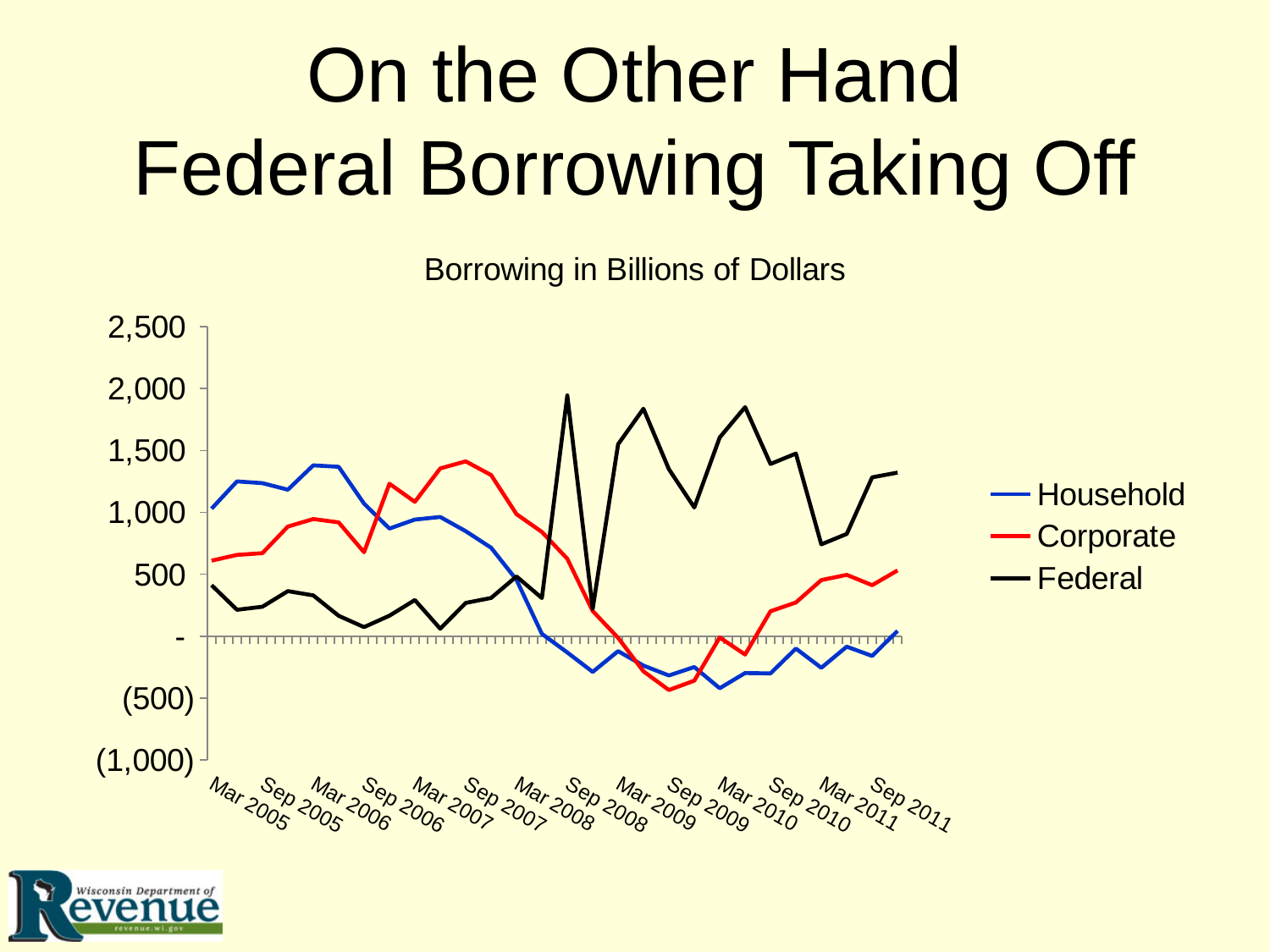
Is the value for Household at Sep 2011 greater or less than 500? less Is the value for Federal at Mar 2005 greater or less than 500? less Which colour is used for the Federal series? black At Mar 2005, which is larger, Household or Federal? Household Overall, does the Federal series rise or fall from Mar 2005 to Sep 2011? rise Which series reaches the highest value anywhere on the chart? Federal Is the value for Corporate at Mar 2005 greater or less than 500? greater What is the title of the chart? Borrowing in Billions of Dollars At Sep 2011, which is larger, Federal or Household? Federal How many series does the legend list? 3 What kind of chart is shown on the slide? line chart